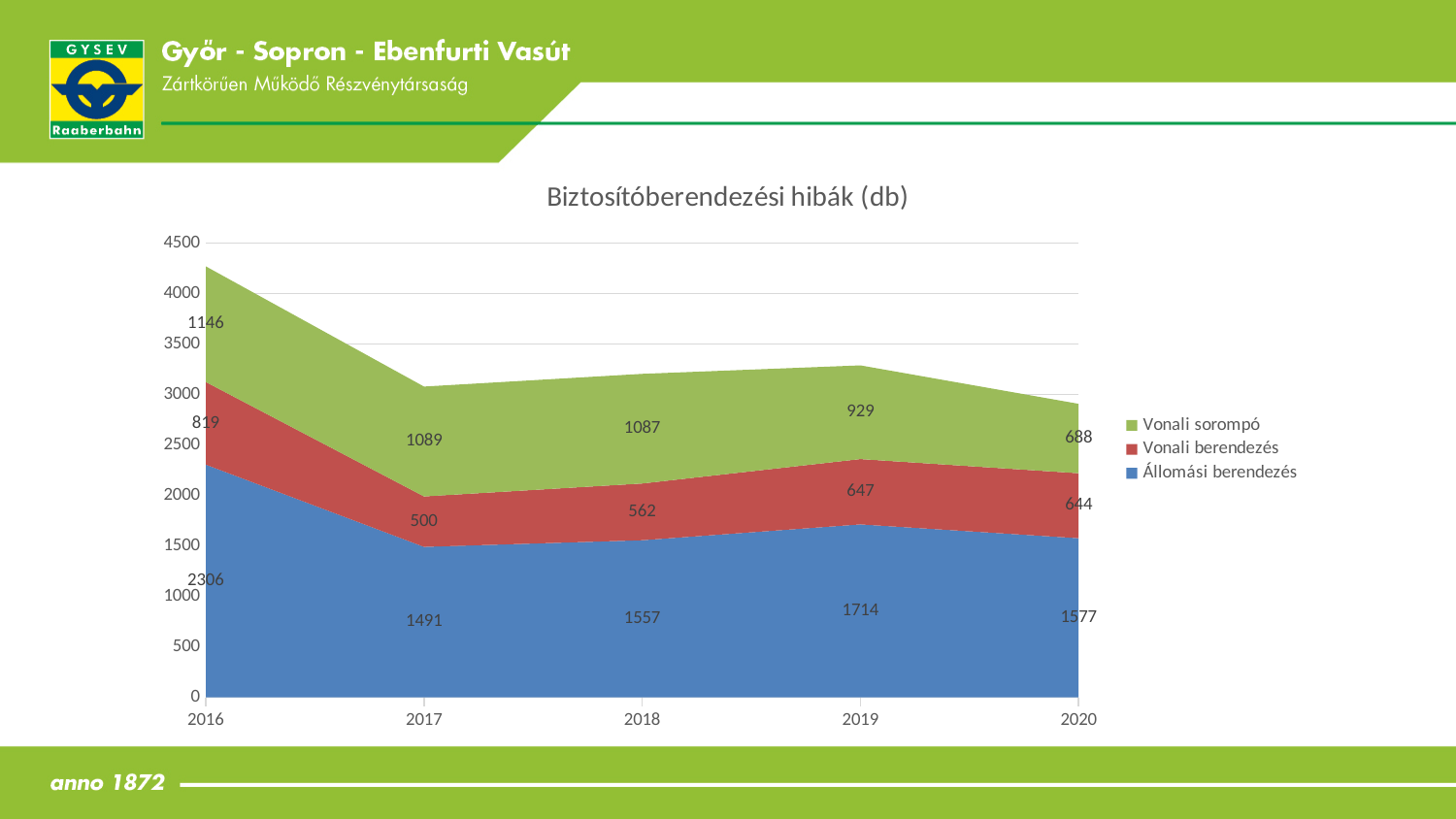
How many series does the legend list? 3 What is the value for Vonali sorompó in 2019? 929 What kind of chart is shown on the slide? Stacked area chart In which year is the Állomási berendezés value highest? 2016 What is the title of the chart? Biztosítóberendezési hibák (db) What is the value for Állomási berendezés in 2016? 2306 How many years are shown on the x axis? 5 Which is larger: Vonali berendezés in 2019 or Vonali berendezés in 2020? 2019 In which year is the Vonali sorompó value lowest? 2020 What is the value for Vonali berendezés in 2017? 500 What is the total of all three series in 2017? 3080 What is the difference between the Állomási berendezés values in 2019 and 2018? 157